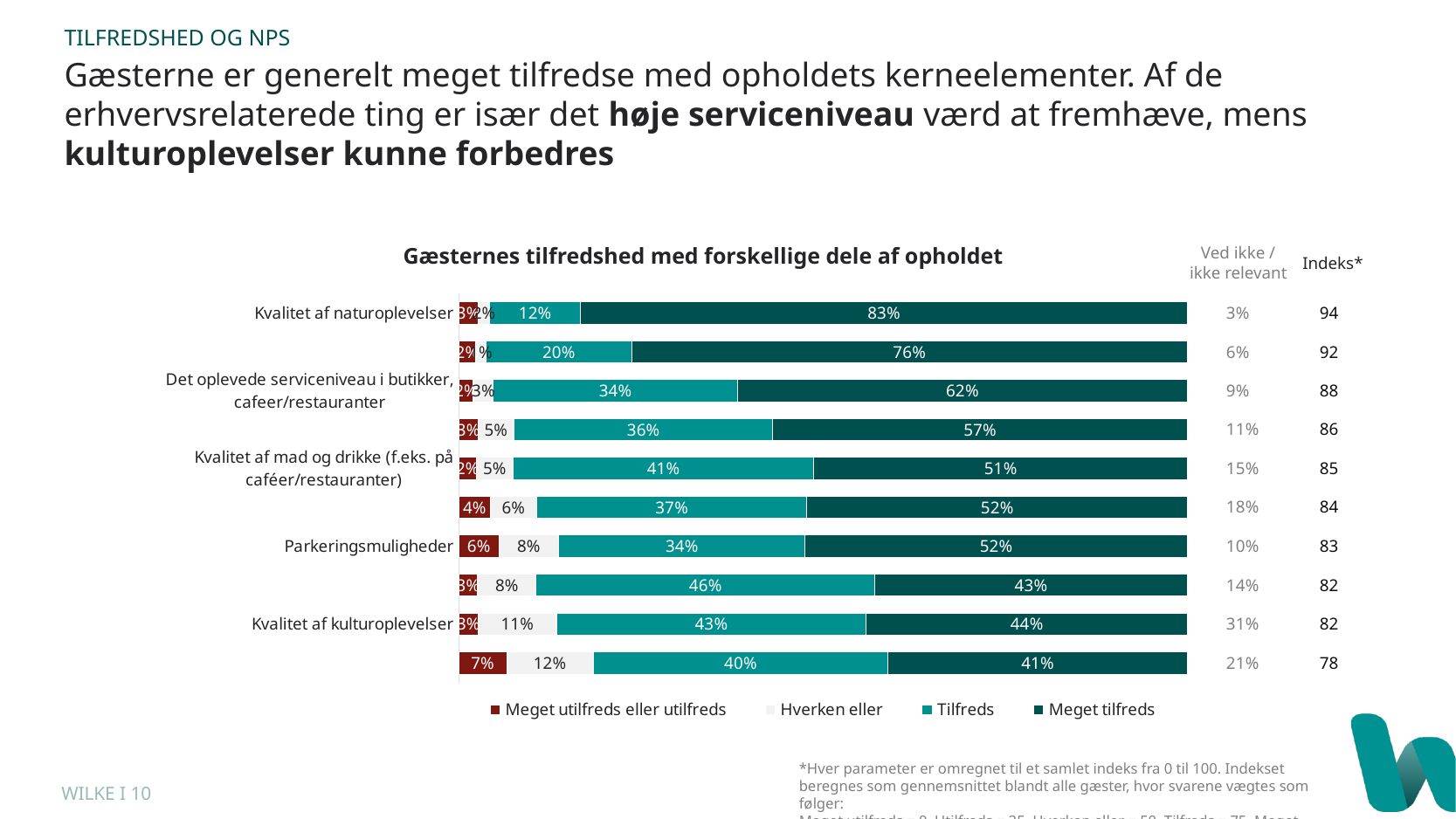
What is the 'Hverken eller' share for 'Kvalitet af kulturoplevelser'? 11% What type of chart is shown on the slide? Stacked bar chart What is the title of the chart? Gæsternes tilfredshed med forskellige dele af opholdet What is the Indeks value shown for 'Kvalitet af naturoplevelser'? 94 Among the labelled categories, which has the highest 'Meget tilfreds' share? Kvalitet af naturoplevelser Which has a larger 'Tilfreds' share: 'Kvalitet af kulturoplevelser' or 'Det oplevede serviceniveau i butikker, cafeer/restauranter'? Kvalitet af kulturoplevelser What is the 'Ved ikke / ikke relevant' share for 'Kvalitet af kulturoplevelser'? 31% What percentage of guests are 'Meget tilfreds' with 'Kvalitet af naturoplevelser'? 83% How many series does the chart legend list? 4 What is the 'Meget tilfreds' share for 'Det oplevede serviceniveau i butikker, cafeer/restauranter'? 62% What is the 'Tilfreds' share for 'Parkeringsmuligheder'? 34% How many percentage points higher is the 'Meget tilfreds' share for 'Kvalitet af naturoplevelser' than for 'Kvalitet af kulturoplevelser'? 39 percentage points